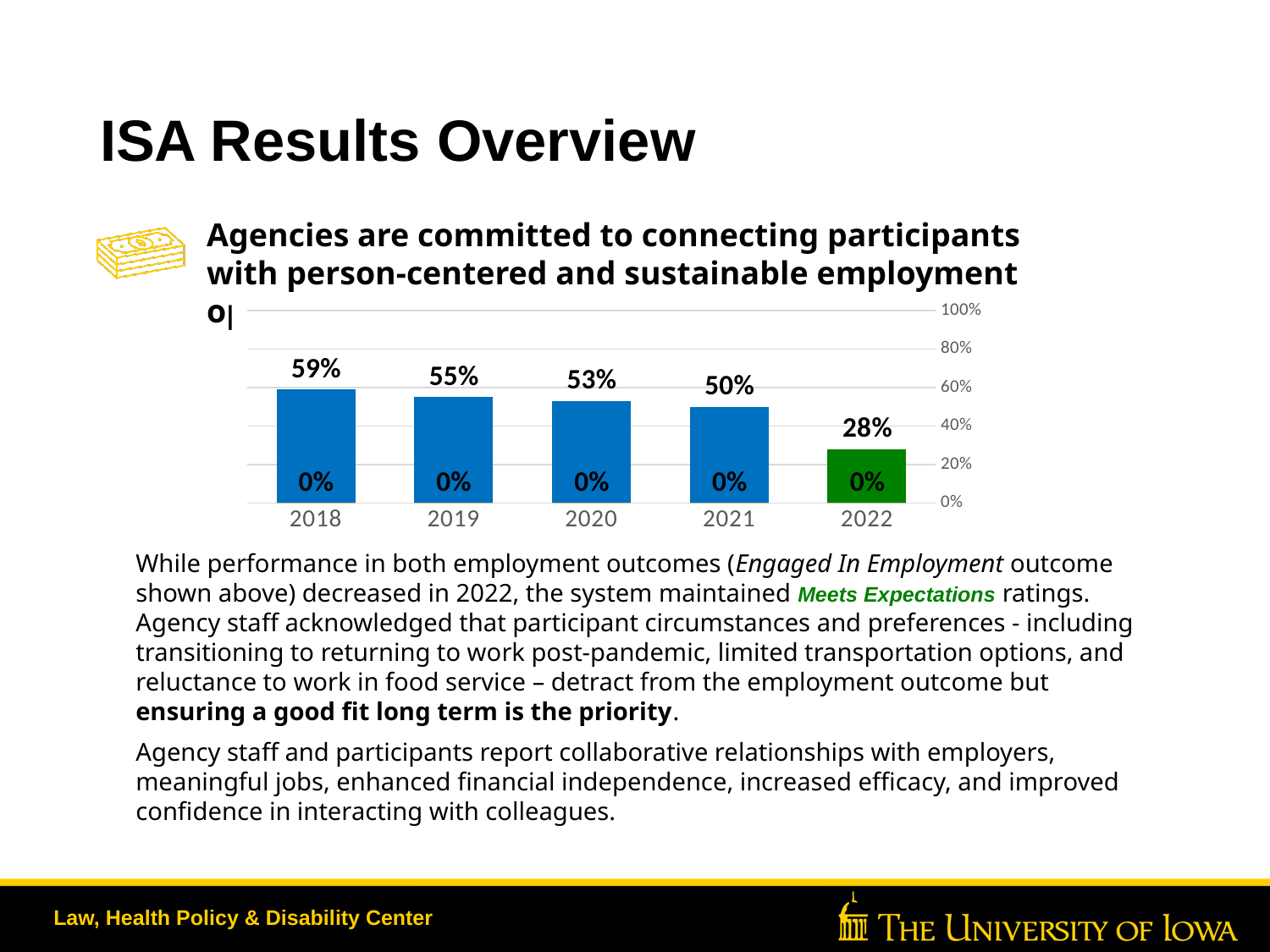
What is the value shown for 2022? 28% Which year has the highest value? 2018 What is the value shown for 2021? 50% What kind of chart is shown on the slide? Bar chart What is the value shown for 2018? 59% Which is larger, the value for 2019 or the value for 2020? 2019 Do the values rise or fall from 2018 to 2022? Fall What is the difference between the values for 2021 and 2022? 22% What is the difference between the values for 2018 and 2019? 4% Which year has the lowest value? 2022 How many years are shown on the x axis? 5 What is the value shown for 2020? 53%